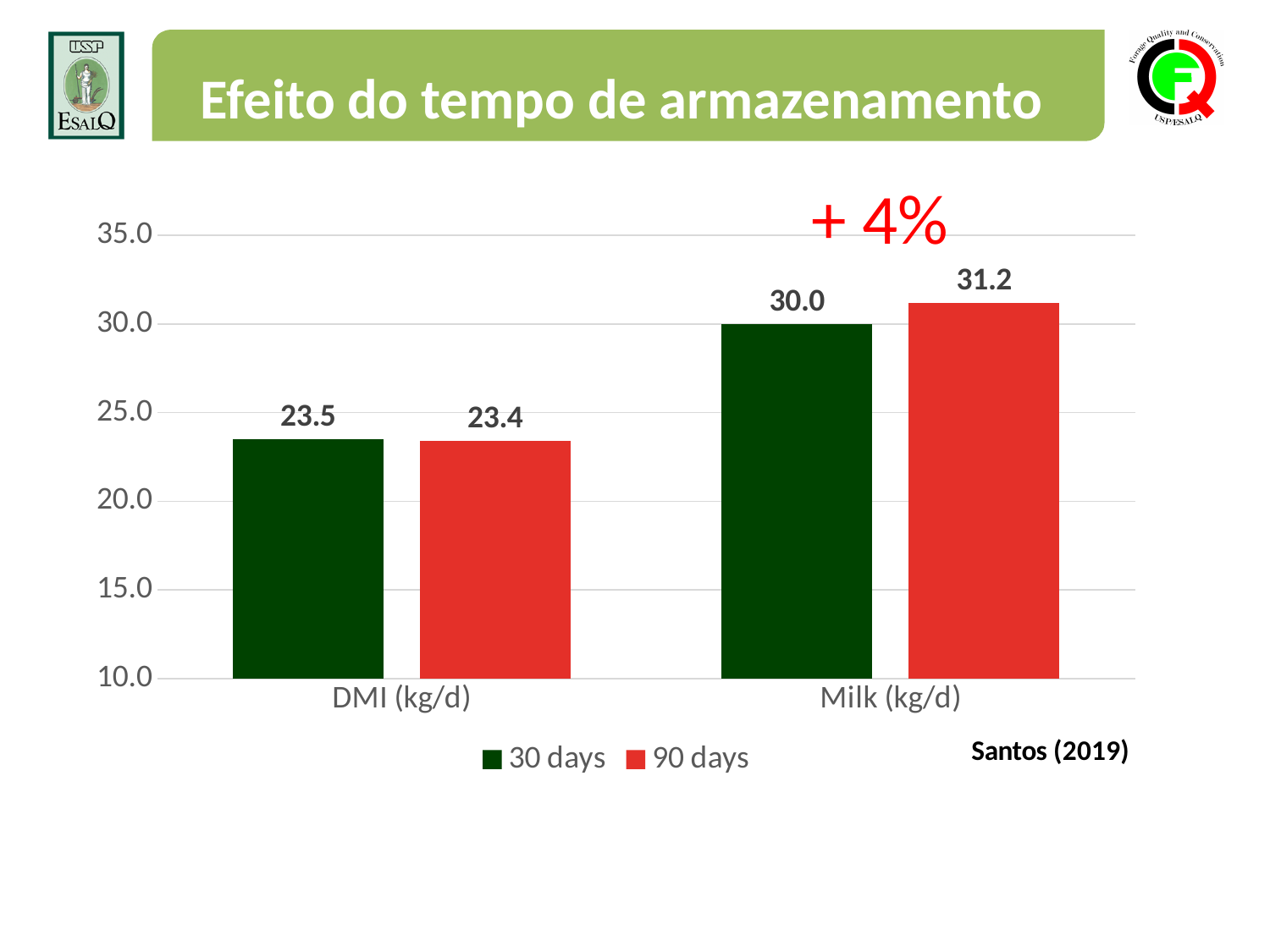
What is the value for 90 days in the Milk (kg/d) category? 31.2 What is the difference between the 30 days and 90 days values for DMI (kg/d)? 0.1 How many categories are shown on the x axis? 2 What is the value for 30 days in the Milk (kg/d) category? 30.0 Is the 30 days value for Milk (kg/d) greater or less than 25.0? greater How many series does the legend list? 2 What is the value for 30 days in the DMI (kg/d) category? 23.5 What kind of chart is shown on the slide? bar chart Which bar has the highest value on the chart? 90 days, Milk (kg/d) What is the difference between the 90 days and 30 days values for Milk (kg/d)? 1.2 What percentage change is annotated above the Milk (kg/d) bars? + 4% What is the value for 90 days in the DMI (kg/d) category? 23.4